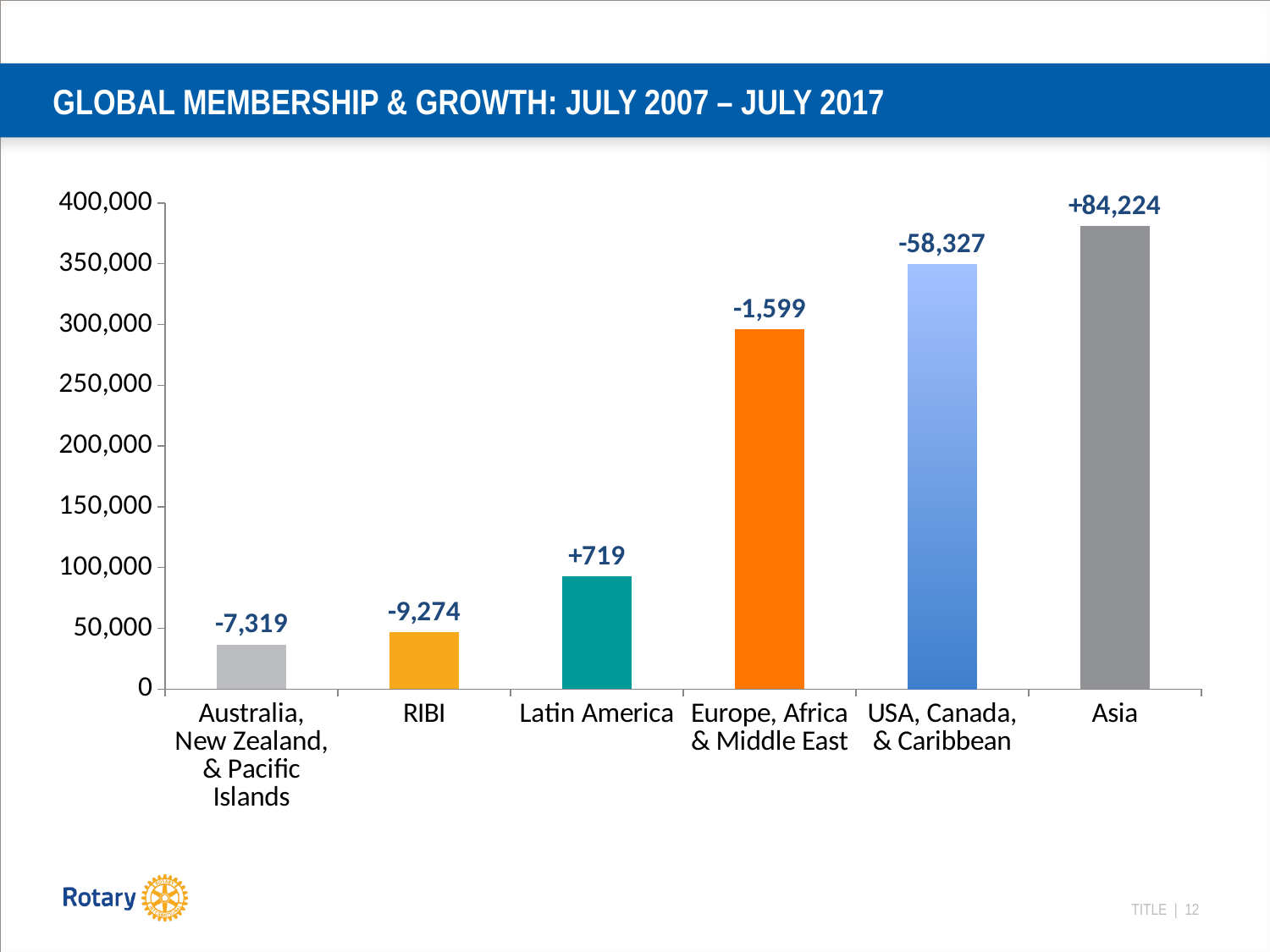
Which region has the tallest bar in the chart? Asia Is the bar for Asia greater or less than 350,000? greater Which region has the shortest bar in the chart? Australia, New Zealand, & Pacific Islands What growth figure is printed above the bar for USA, Canada, & Caribbean? -58,327 What kind of chart is shown on the slide? bar chart By how much does the printed growth figure for Asia exceed the printed growth figure for Latin America? 83,505 How many regions are shown on the x axis of the chart? 6 What growth figure is printed above the bar for RIBI? -9,274 Is the bar for Latin America greater or less than 100,000? less What growth figure is printed above the bar for Latin America? +719 What growth figure is printed above the bar for Asia? +84,224 What is the title of the chart on the slide? GLOBAL MEMBERSHIP & GROWTH: JULY 2007 – JULY 2017